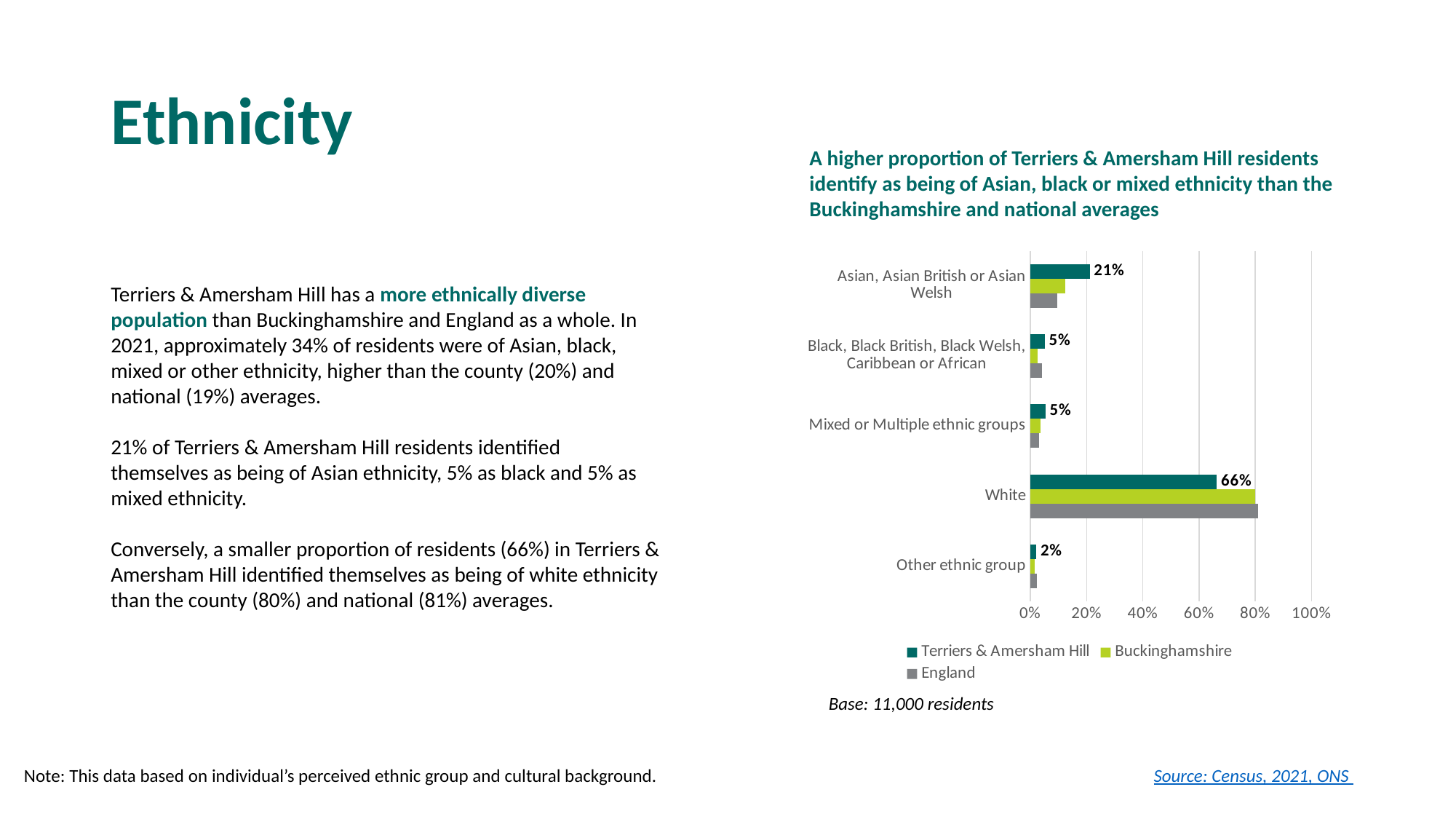
In the White category, which series has the larger value: Terriers & Amersham Hill or Buckinghamshire? Buckinghamshire Is the Buckinghamshire value for White greater or less than 60%? greater Which category has the lowest value for Terriers & Amersham Hill? Other ethnic group What type of chart is shown on the slide? Bar chart What is the value for Terriers & Amersham Hill in the Other ethnic group category? 2% How many series does the chart legend list? 3 What percentage of Terriers & Amersham Hill residents identify as Asian, Asian British or Asian Welsh? 21% Which category has the highest value for Terriers & Amersham Hill? White Is the England value for Asian, Asian British or Asian Welsh greater or less than 20%? less How many ethnic group categories are shown on the chart? 5 What is the difference between the Terriers & Amersham Hill values for White and for Asian, Asian British or Asian Welsh? 45 percentage points What is the value for Terriers & Amersham Hill in the White category? 66%